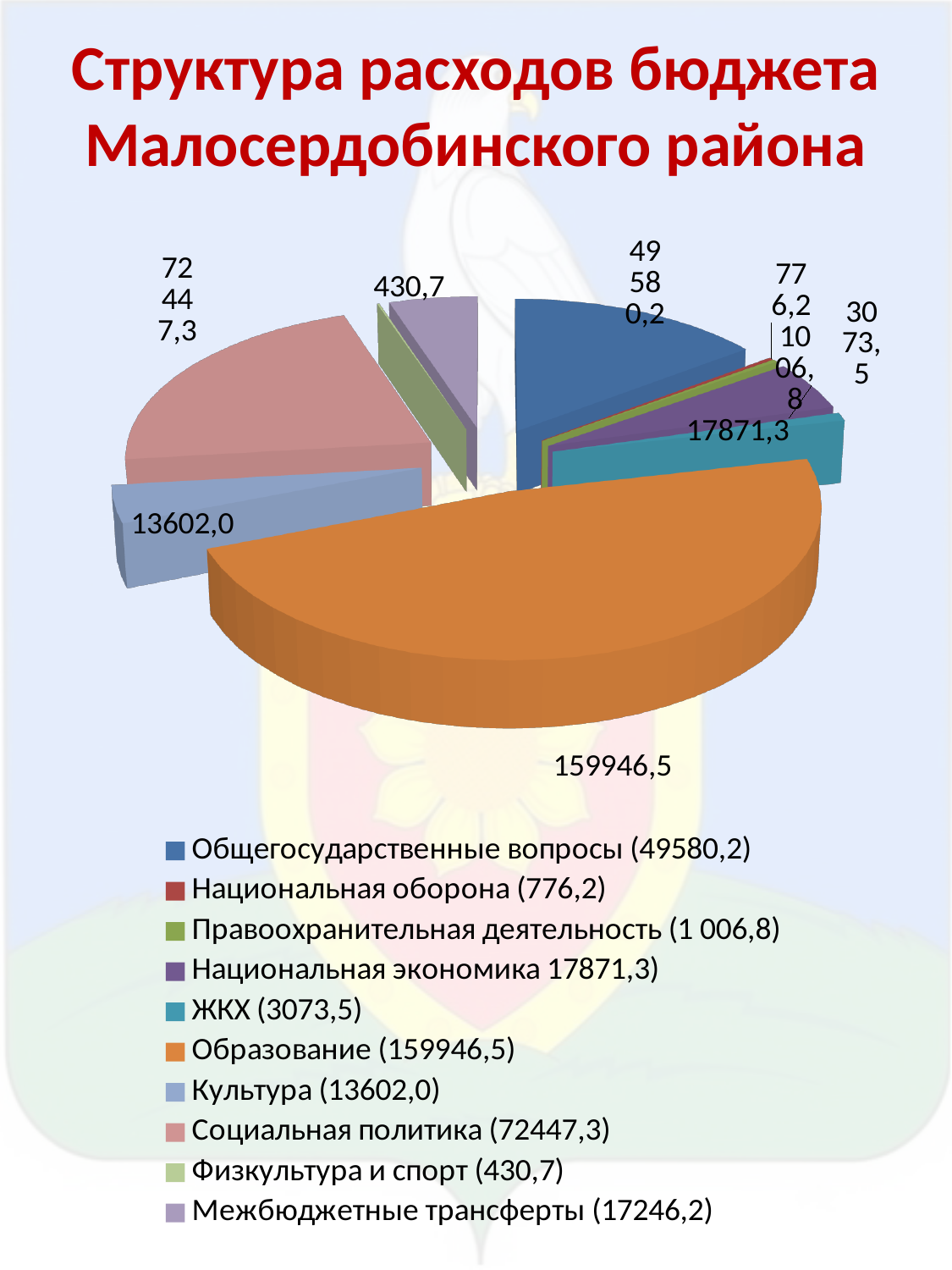
What is the difference between Образование and Социальная политика? 87499,2 What is the value for Социальная политика? 72447,3 How many categories does the pie chart legend list? 10 What is the value for ЖКХ? 3073,5 What type of chart is shown on the slide? Pie chart Which is larger: Культура or Межбюджетные трансферты? Межбюджетные трансферты Which category has the smallest value? Физкультура и спорт What is the value for Межбюджетные трансферты? 17246,2 What is the value for Образование? 159946,5 Which category has the largest share of the pie? Образование What is the difference between Общегосударственные вопросы and Национальная экономика? 31708,9 What is the title of the chart on the slide? Структура расходов бюджета Малосердобинского района